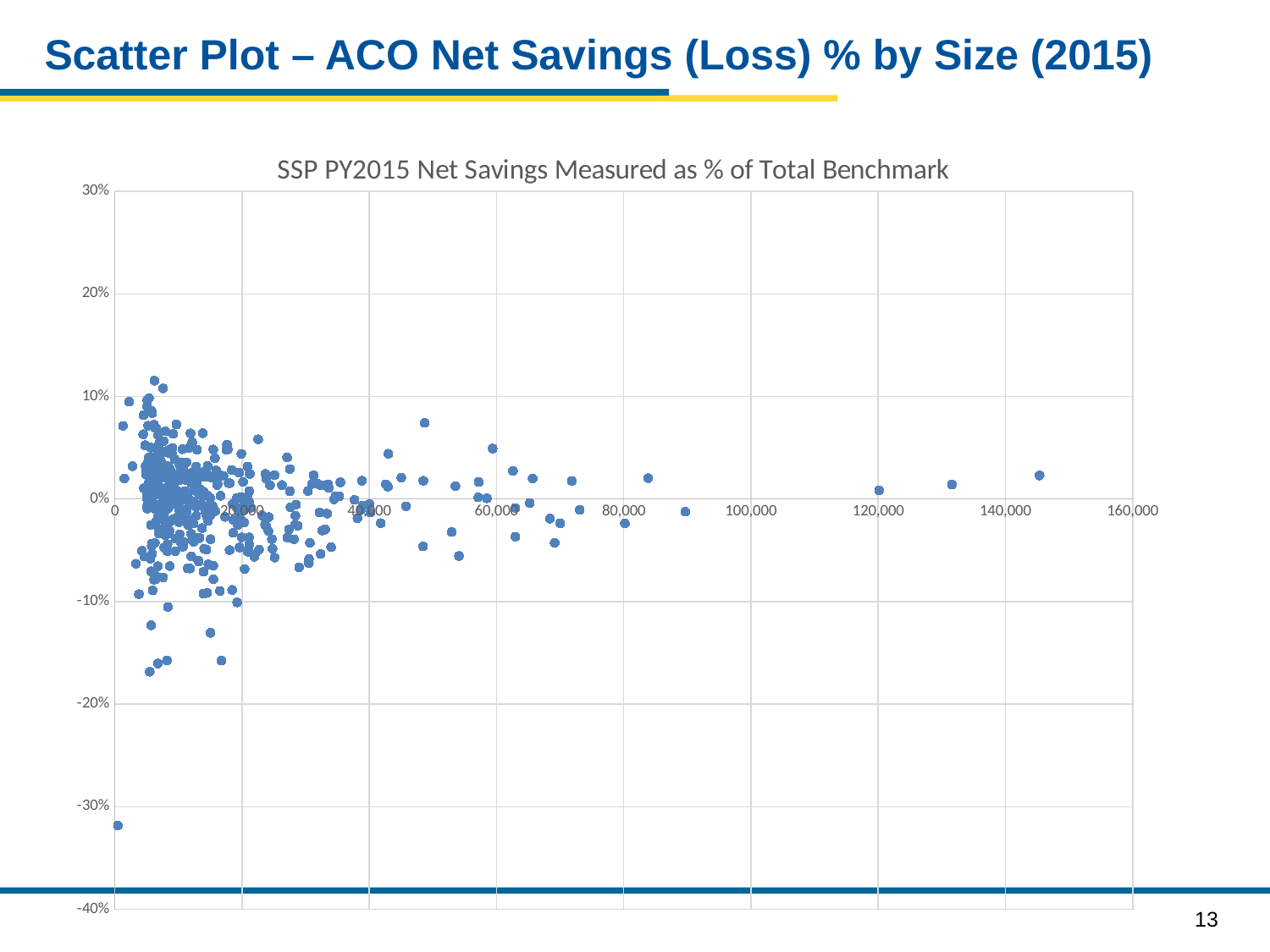
Is the net savings value for the highest point on the chart greater or less than 5%? greater What is the title of the chart? SSP PY2015 Net Savings Measured as % of Total Benchmark Is the x value of the lowest point on the chart greater or less than 20,000? less What is the highest value labelled on the vertical axis of the chart? 30% Is the x value of the furthest-right point greater or less than 140,000? greater What kind of chart is shown on the slide? scatter plot